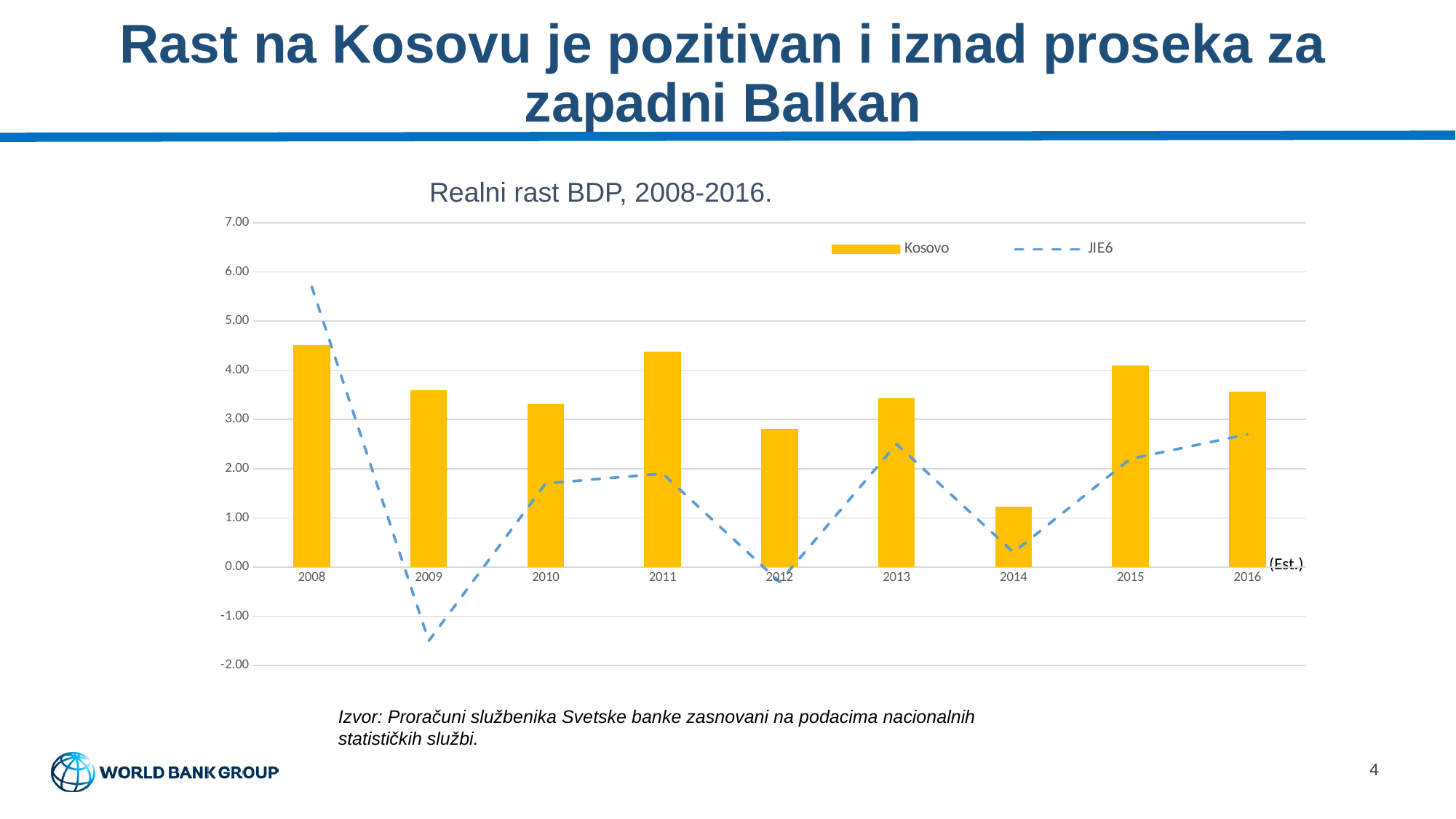
What kind of chart is used for the Kosovo series? bar chart Is the JIE6 value for 2009 greater or less than -1.00? less Which series is shown as a dashed line? JIE6 What is the title of the chart? Realni rast BDP, 2008-2016. How many series does the chart legend list? 2 In which year is the Kosovo value lowest? 2014 In 2009, which is larger, the Kosovo value or the JIE6 value? Kosovo In which year is the JIE6 value highest? 2008 Does the JIE6 line rise or fall from 2014 to 2016? rise How many years are shown on the x axis? 9 Is the Kosovo value for 2014 greater or less than 2.00? less In which year is the JIE6 value lowest? 2009